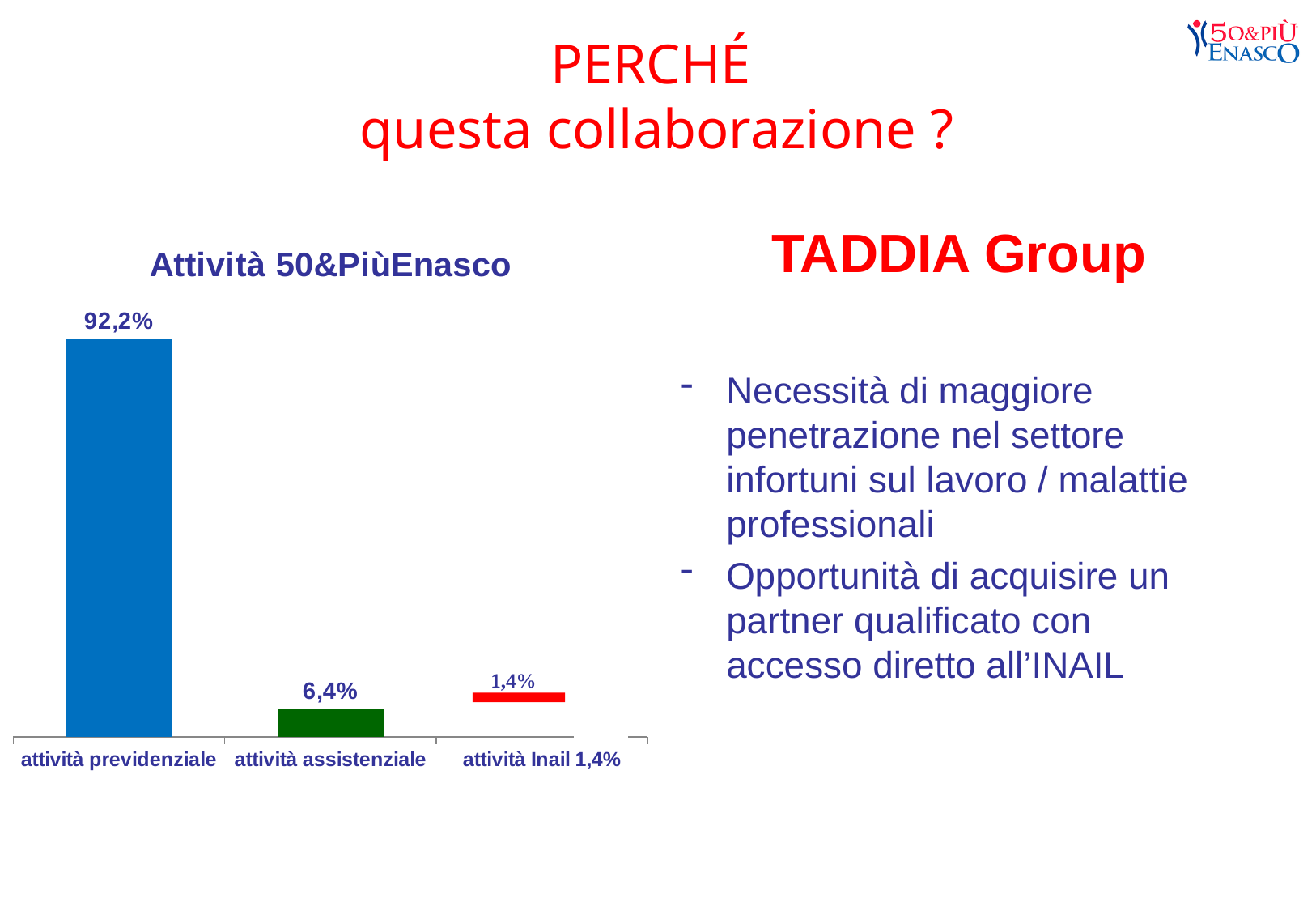
What colour is the bar for attività Inail? red Which is larger, attività assistenziale or attività Inail? attività assistenziale What is the value for attività Inail? 1,4% What is the title of the chart? Attività 50&PiùEnasco Which category has the lowest value? attività Inail What is the value for attività previdenziale? 92,2% Which category has the highest value? attività previdenziale What is the value for attività assistenziale? 6,4% What kind of chart is shown on the slide? bar chart How many categories are shown in the chart? 3 What is the difference between attività assistenziale and attività Inail? 5,0% What is the difference between attività previdenziale and attività assistenziale? 85,8%